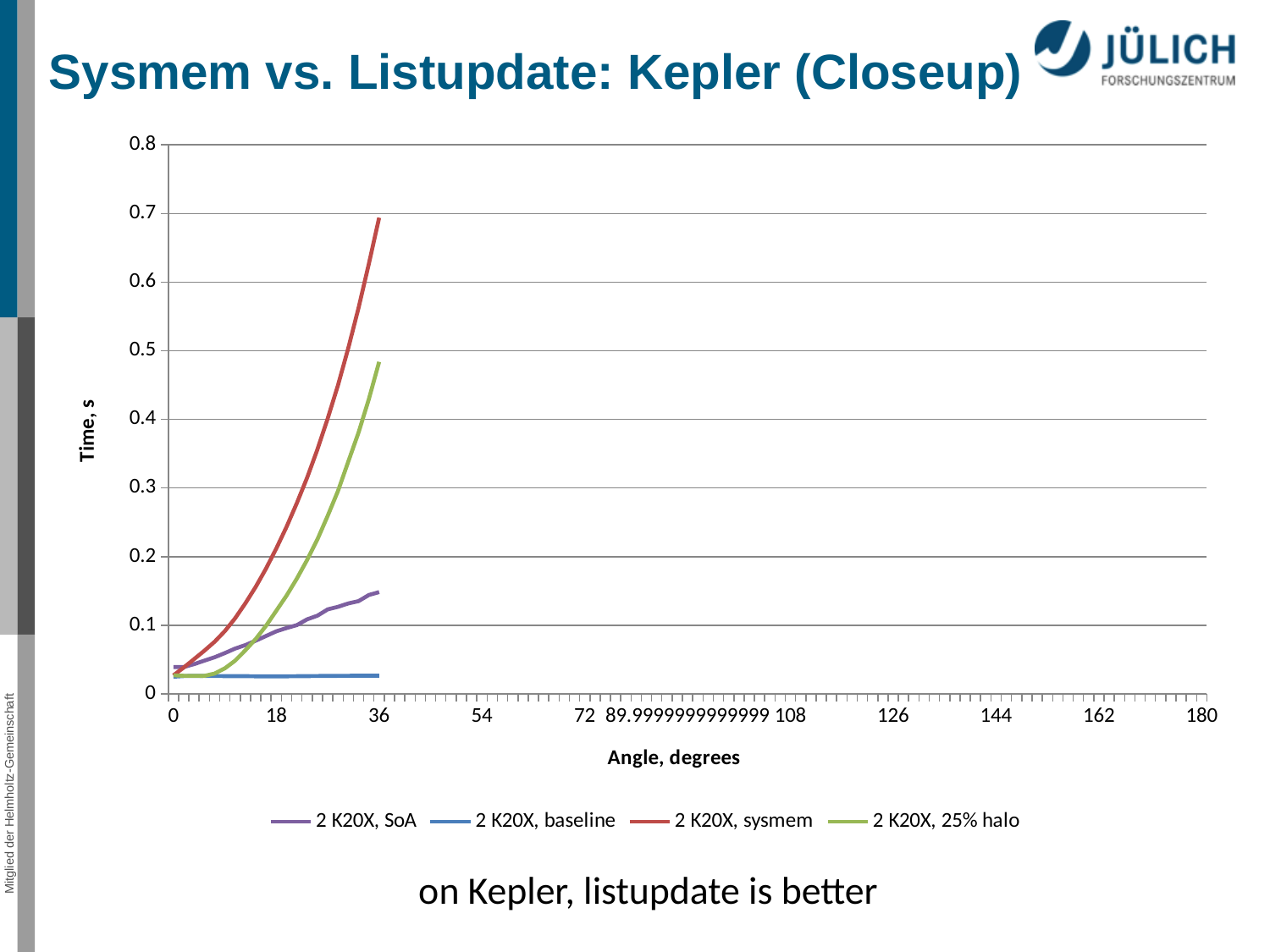
Is the value for 2 K20X, baseline at 36 degrees greater or less than 0.1? less Is the value for 2 K20X, sysmem at 36 degrees greater or less than 0.6? greater What kind of chart is shown on the slide? line chart What is the label of the y axis? Time, s What is the title of the chart on the slide? Sysmem vs. Listupdate: Kepler (Closeup) Which series has the lowest time at an angle of 36 degrees? 2 K20X, baseline Which series reaches the highest time at an angle of 36 degrees? 2 K20X, sysmem Is the value for 2 K20X, 25% halo at 36 degrees greater or less than 0.4? greater At 36 degrees, which is larger: the value for 2 K20X, sysmem or the value for 2 K20X, 25% halo? 2 K20X, sysmem Does the time for 2 K20X, sysmem rise or fall as the angle increases from 0 to 36 degrees? rise How many series does the legend list? 4